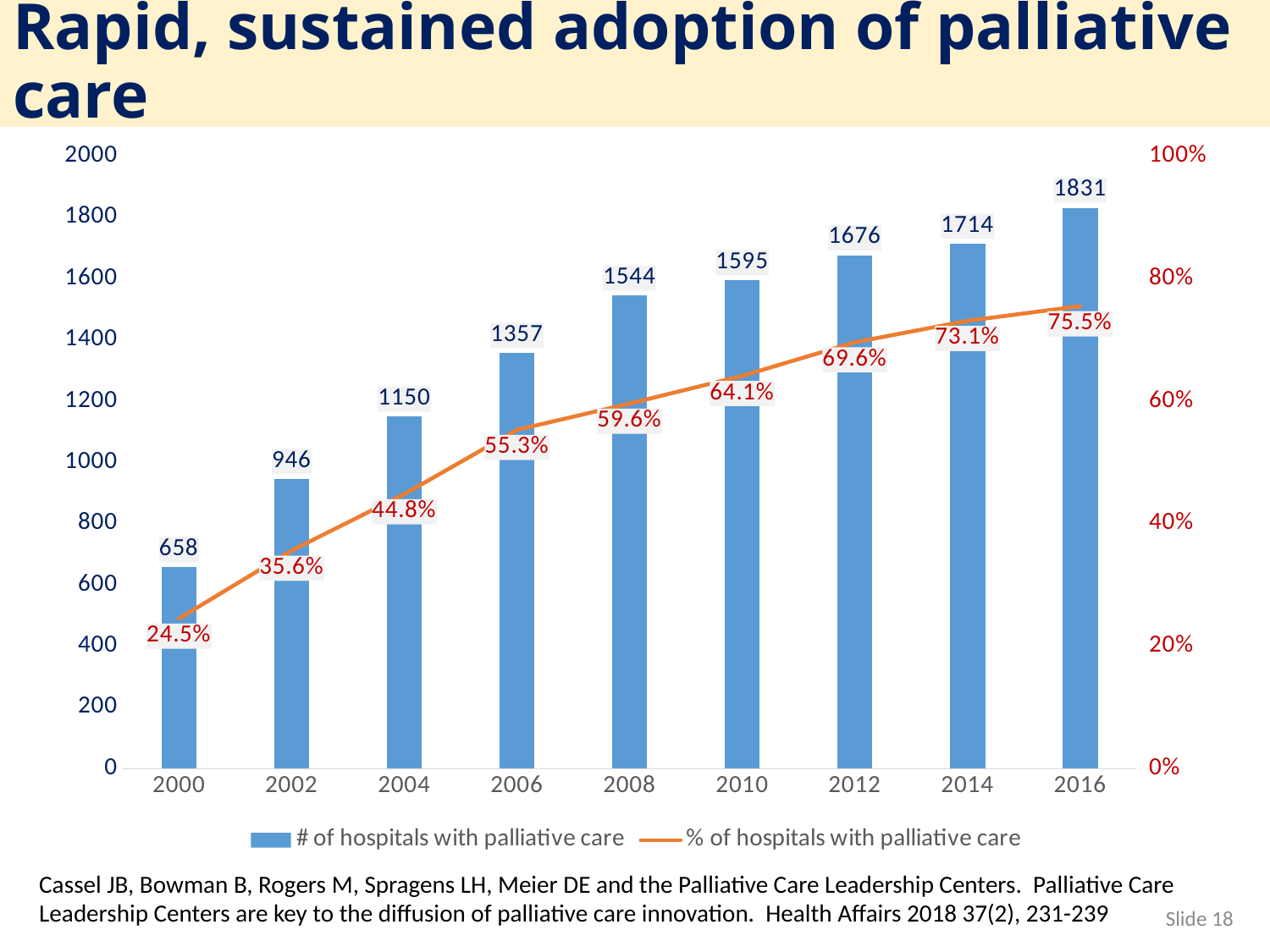
How many series does the legend list? 2 What is the difference in the number of hospitals with palliative care between 2016 and 2014? 117 How many years are shown on the x axis? 9 Which is larger, the number of hospitals with palliative care in 2006 or in 2010? 2010 Is the number of hospitals with palliative care in 2012 greater or less than 1600? greater What kind of chart is shown on the slide? Combined bar and line chart Which year has the highest number of hospitals with palliative care? 2016 What is the % of hospitals with palliative care in 2004? 44.8% Which year has the lowest % of hospitals with palliative care? 2000 Does the % of hospitals with palliative care rise or fall from 2000 to 2016? Rise What is the number of hospitals with palliative care in 2000? 658 What is the number of hospitals with palliative care in 2008? 1544